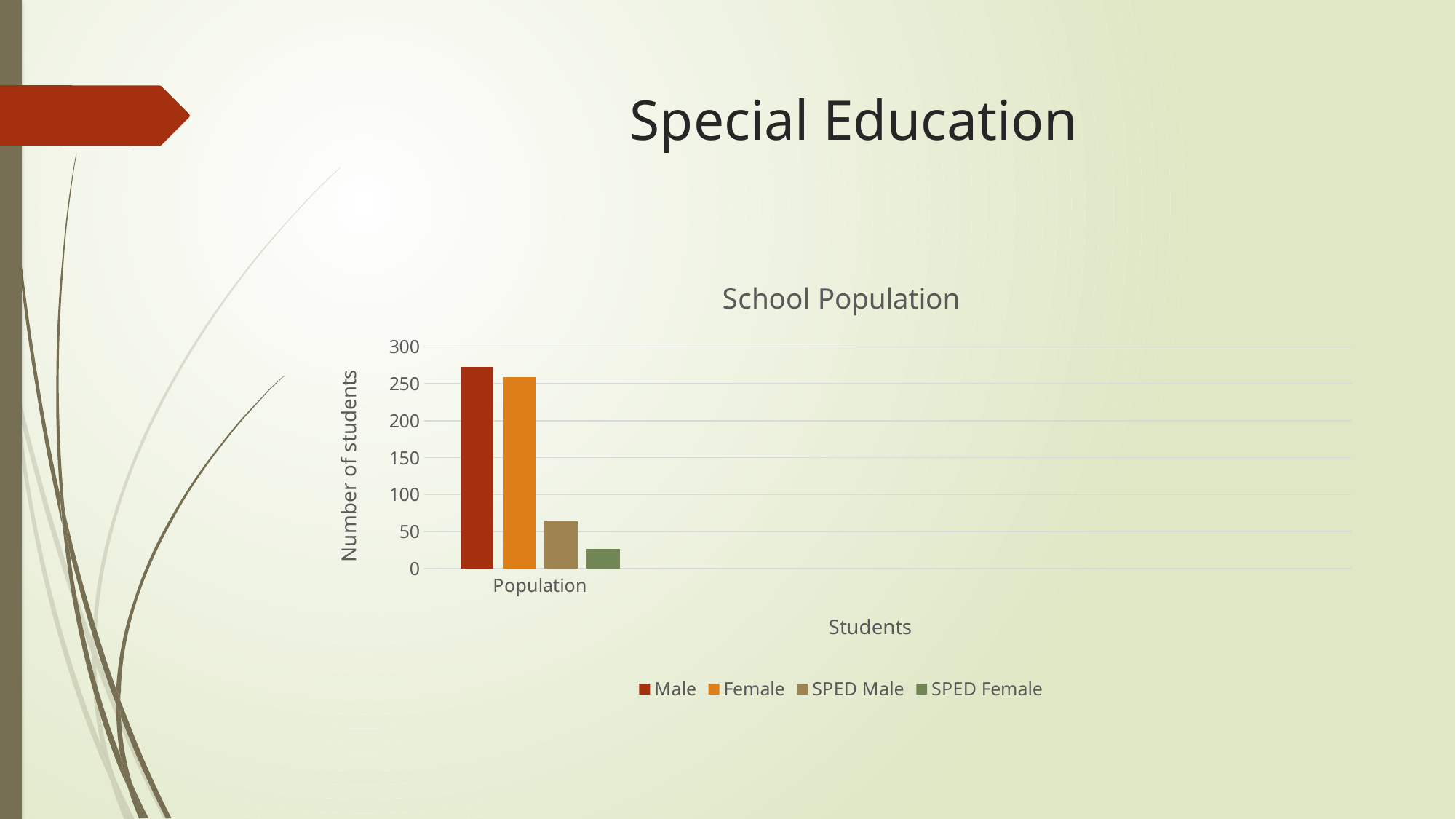
Is the value for SPED Female greater or less than 50? less What kind of chart is shown on the slide? bar chart How many categories are shown on the x axis? 1 What is the label on the vertical axis? Number of students Is the value for Male greater or less than 250? greater Which is larger, SPED Male or SPED Female? SPED Male What is the title of the chart? School Population How many series does the legend list? 4 Is the value for SPED Male greater or less than 100? less Which is larger, Female or SPED Male? Female Which series has the lowest value? SPED Female